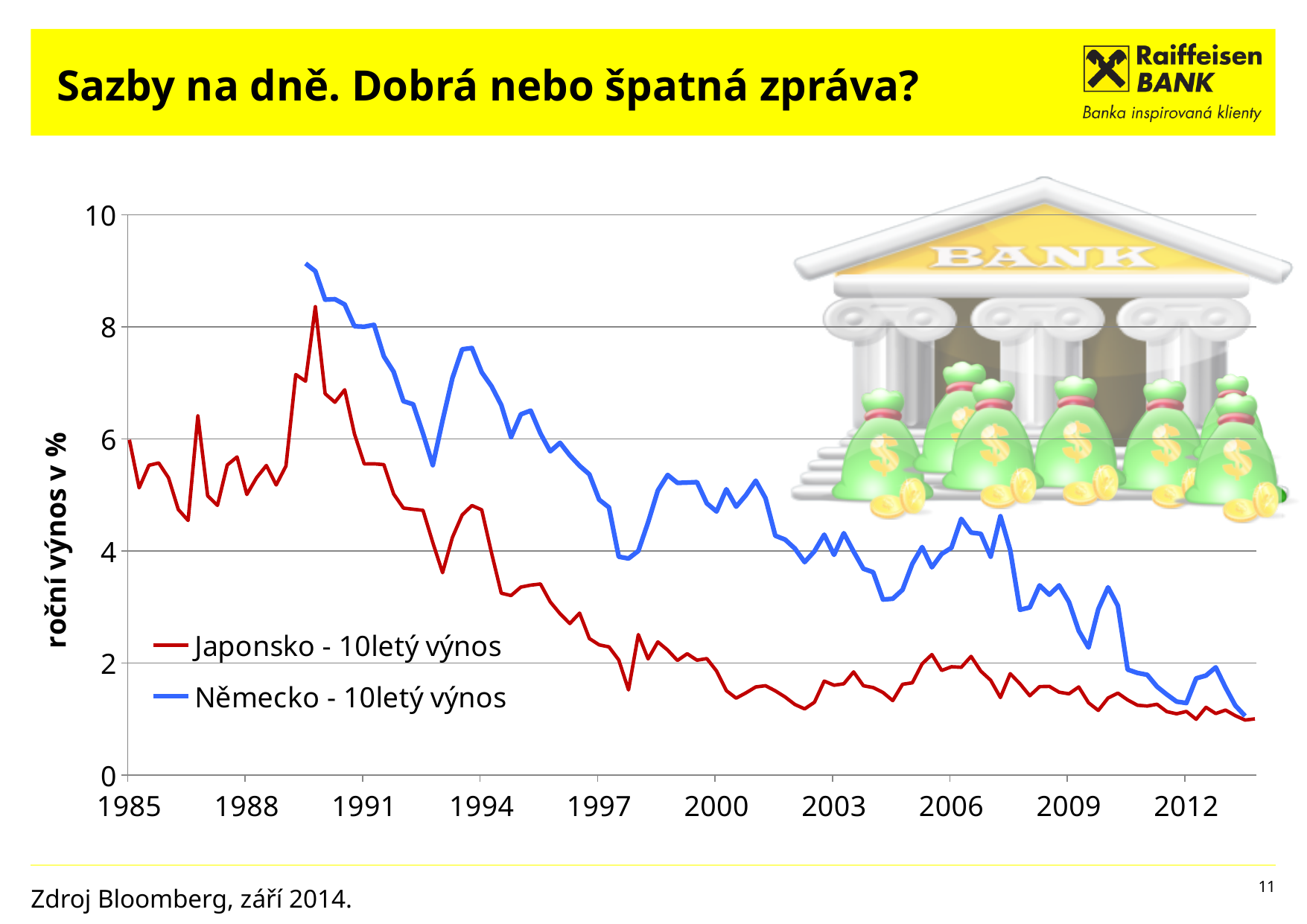
What is the label of the y axis? roční výnos v % Do the values of the Německo - 10letý výnos series rise or fall overall from 1990 to the end of the chart? fall Do the values of the Japonsko - 10letý výnos series rise or fall overall from 1985 to the end of the chart? fall What kind of chart is shown on the slide? line chart Is the value for Japonsko - 10letý výnos in 1985 greater or less than 4? greater Which series reaches the higher peak value on the chart? Německo - 10letý výnos Is the value for Německo - 10letý výnos at its start around 1990 greater or less than 8? greater Is the value for Japonsko - 10letý výnos in 2012 greater or less than 2? less In 1991, which series has the higher value, Japonsko - 10letý výnos or Německo - 10letý výnos? Německo - 10letý výnos Which colour is used for the Německo - 10letý výnos series? blue How many series does the legend list? 2